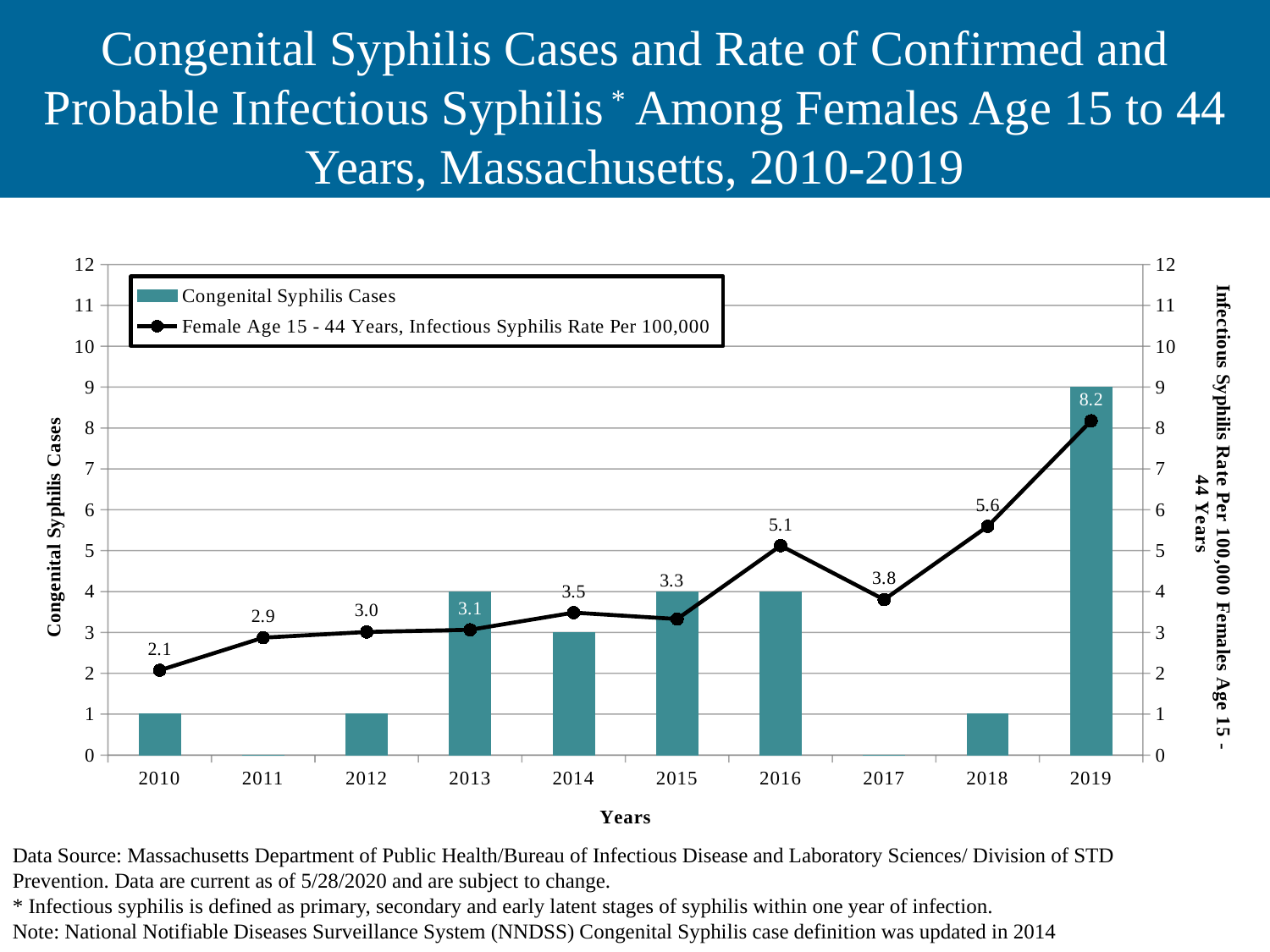
Did the infectious syphilis rate among females age 15-44 rise or fall from 2017 to 2019? Rise How many series does the chart legend list? 2 What is the difference between the infectious syphilis rate in 2019 and in 2018? 2.6 What was the infectious syphilis rate per 100,000 among females age 15-44 in 2019? 8.2 What kinds of chart are combined in this figure? Bar chart and line chart Which year had a higher infectious syphilis rate among females age 15-44, 2016 or 2017? 2016 In which year was the infectious syphilis rate among females age 15-44 the lowest? 2010 In which year was the number of congenital syphilis cases the highest? 2019 What was the infectious syphilis rate per 100,000 among females age 15-44 in 2016? 5.1 How many years are shown on the x axis of the chart? 10 How many congenital syphilis cases were reported in 2019? 9 How many congenital syphilis cases were reported in 2014? 3